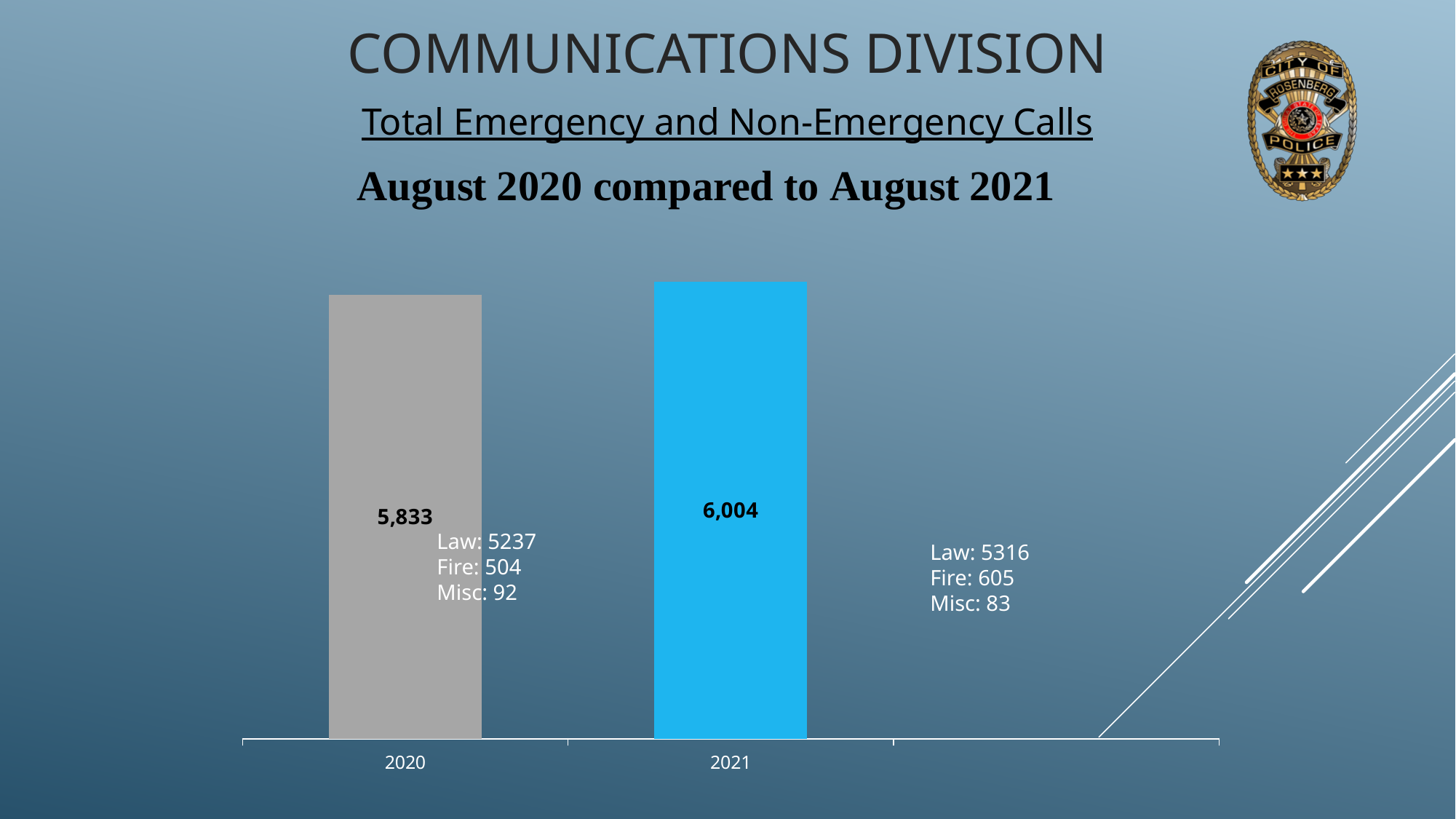
Do the values rise or fall from 2020 to 2021? Rise What is the difference between the 2021 and 2020 bar values? 171 Which year has the lower bar? 2020 What is the value of the bar for 2020? 5,833 What kind of chart is shown on the slide? Bar chart According to the text annotation, how many Law calls were there in 2020? 5237 What colour is the bar for 2021? Blue What is the value of the bar for 2021? 6,004 Is the value for 2021 larger than the value for 2020? Yes Which year has the higher bar? 2021 According to the text annotation, how many Fire calls were there in 2021? 605 How many bars are plotted in the chart? 2